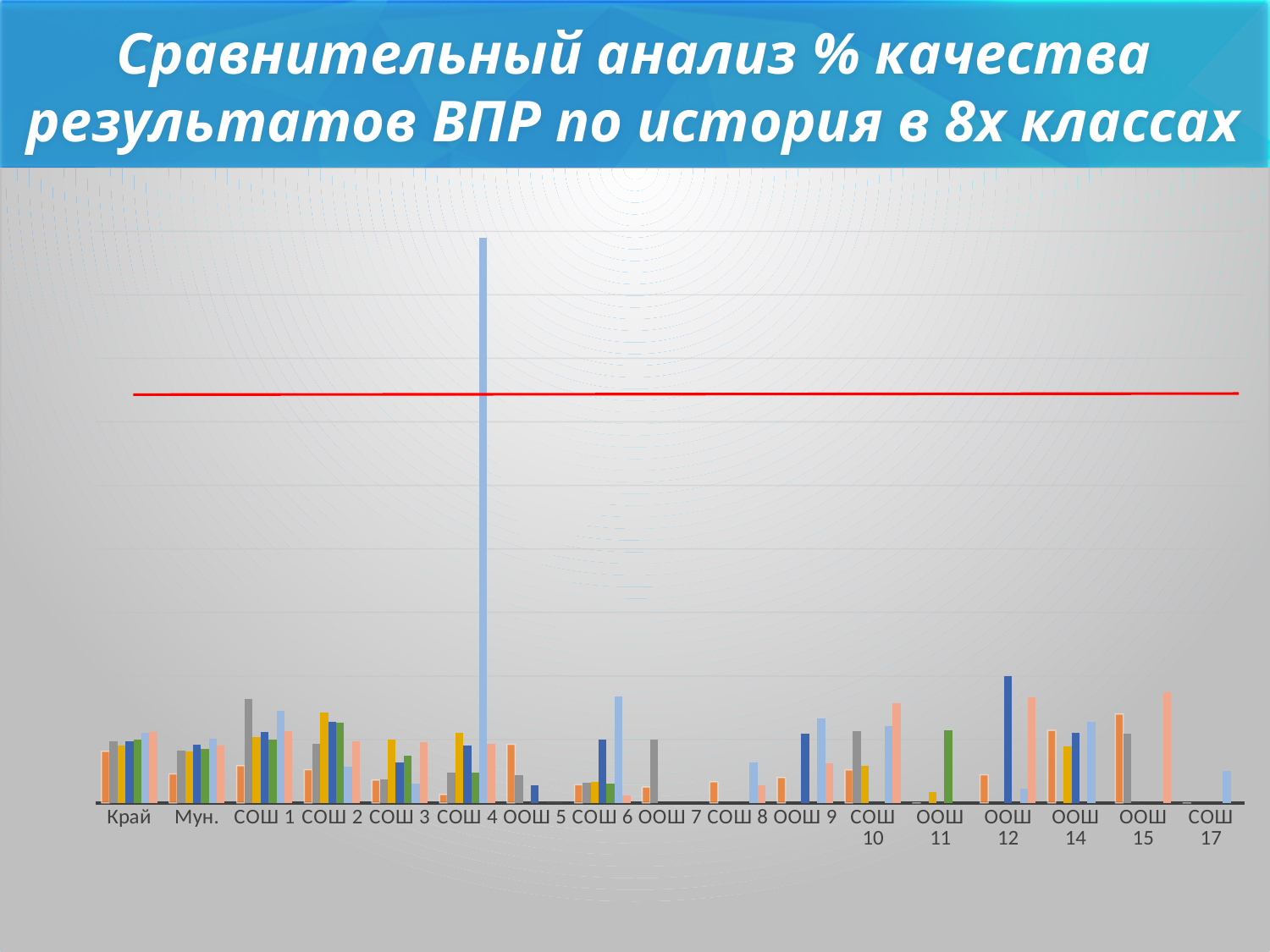
Is the tallest bar in the chart above or below the red horizontal line? above Which is the last category on the x axis of the chart? СОШ 17 Which category contains the tallest bar in the chart? СОШ 4 Which category has the taller bars overall: СОШ 4 or ООШ 7? СОШ 4 Which is the first category on the x axis of the chart? Край Which category comes immediately after Мун. on the x axis? СОШ 1 What kind of chart is shown on the slide? bar chart What is the title of the slide containing the chart? Сравнительный анализ % качества результатов ВПР по история в 8х классах What colour is the horizontal line drawn across the chart? red How many categories are shown along the x axis of the chart? 17